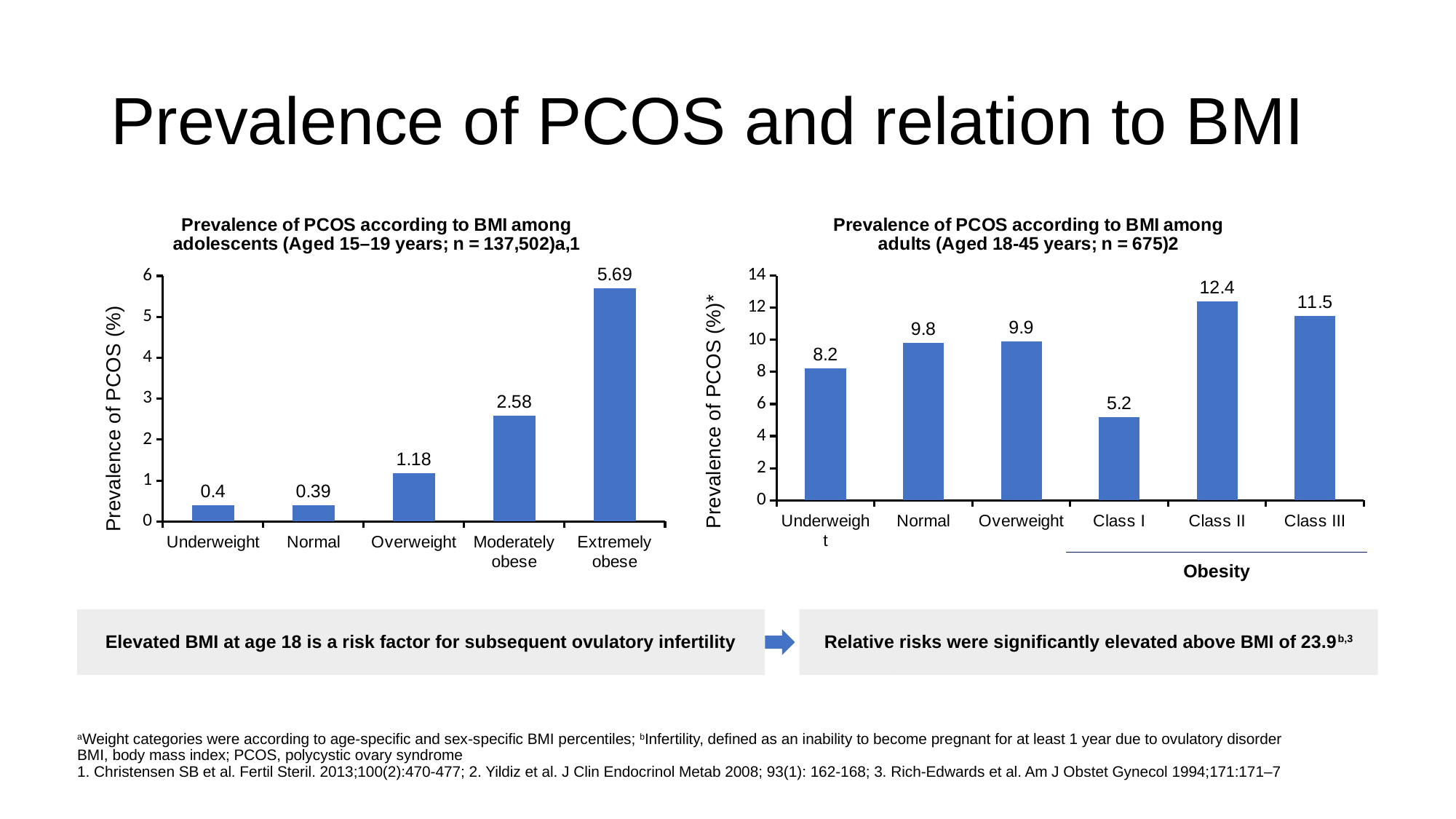
In the adults chart on the right, what is the prevalence of PCOS for Class II? 12.4 In the adults chart on the right, which category has the lowest prevalence of PCOS? Class I In the adolescents chart on the left, which category has the highest prevalence of PCOS? Extremely obese How many categories are shown in the adults chart on the right? 6 In the adolescents chart on the left, what is the difference between the Extremely obese and Moderately obese values? 3.11 In the adolescents chart on the left, what is the label of the y axis? Prevalence of PCOS (%) In the adults chart on the right, what is the prevalence of PCOS for Underweight? 8.2 In the adults chart on the right, what is the difference between the Class II and Class III values? 0.9 In the adults chart on the right, which is larger: the value for Normal or the value for Class I? Normal In the adolescents chart on the left, what is the prevalence of PCOS for the Extremely obese category? 5.69 In the adolescents chart on the left, what is the prevalence of PCOS for the Overweight category? 1.18 What kind of chart is the adolescents chart on the left? Bar chart